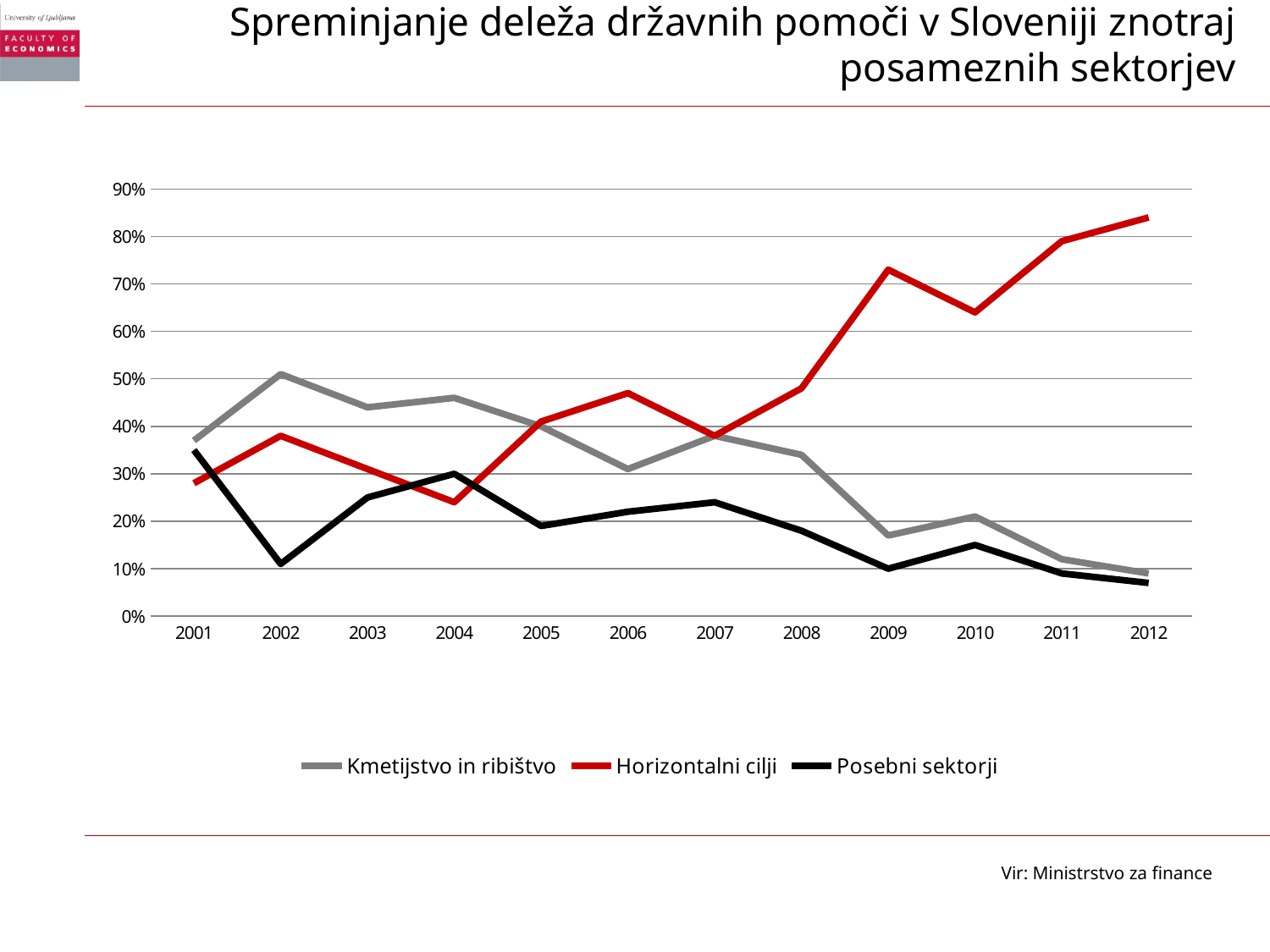
In which year does the Horizontalni cilji series reach its highest value? 2012 Is the value for Posebni sektorji in 2002 greater or less than 20%? less Is the value for Kmetijstvo in ribištvo in 2009 greater or less than 20%? less In 2001, which series has the larger value: Kmetijstvo in ribištvo or Horizontalni cilji? Kmetijstvo in ribištvo Is the value for Horizontalni cilji in 2009 greater or less than 70%? greater In 2012, which series has the larger value: Horizontalni cilji or Kmetijstvo in ribištvo? Horizontalni cilji What kind of chart is shown on the slide? line chart Does the Horizontalni cilji series overall rise or fall from 2001 to 2012? rise How many series does the legend list? 3 How many years are plotted along the x axis? 12 What colour is the line for Horizontalni cilji? red In which year does the Kmetijstvo in ribištvo series reach its highest value? 2002